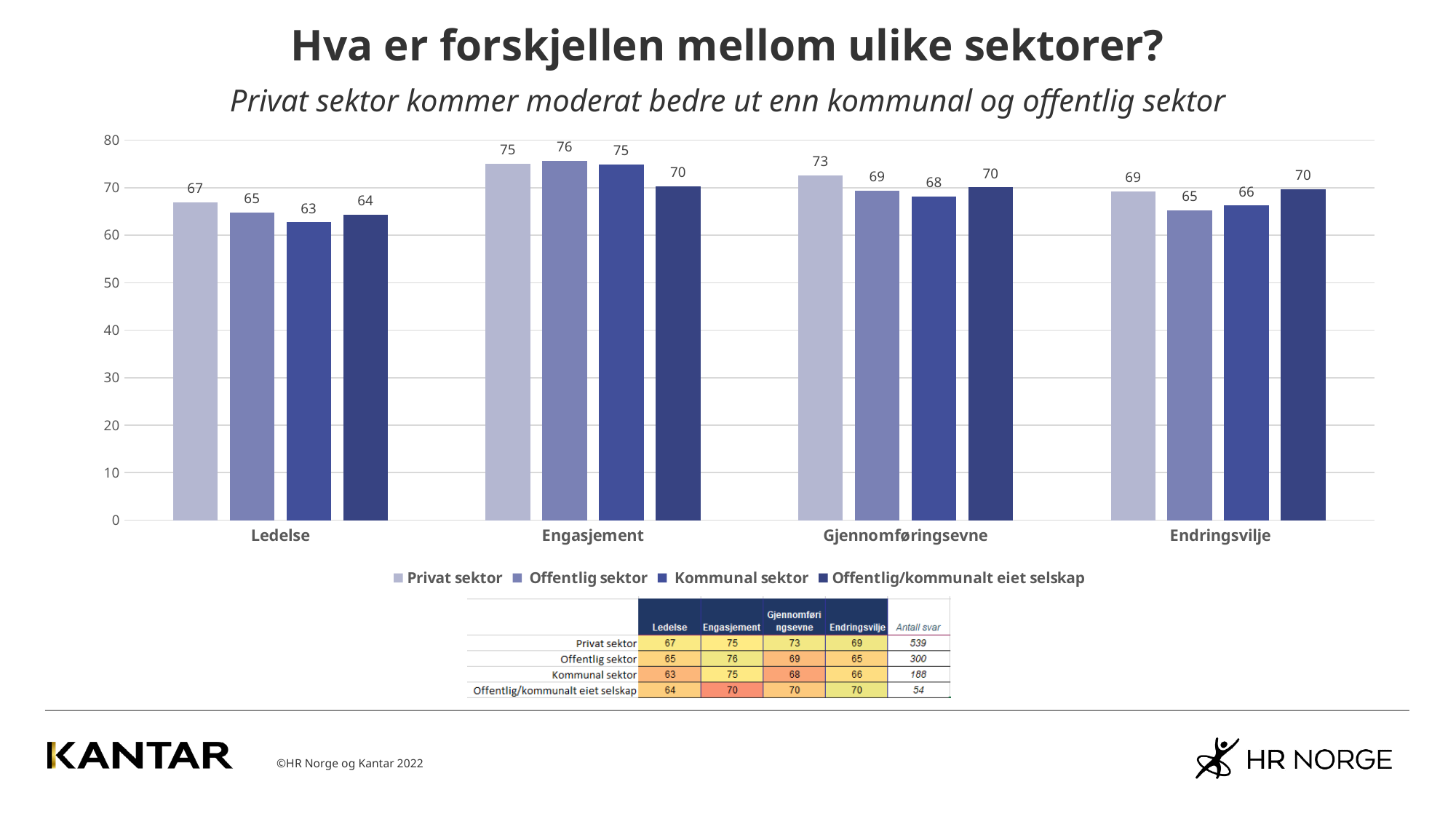
What is the value for Kommunal sektor in the Gjennomføringsevne category? 68 How many series does the legend list? 4 What is the difference between Privat sektor and Kommunal sektor in the Ledelse category? 4 Which sector has the lowest value in the Ledelse category? Kommunal sektor What is the title of the slide? Hva er forskjellen mellom ulike sektorer? How many categories are shown on the x axis of the chart? 4 What kind of chart is shown on the slide? Bar chart What is the value for Privat sektor in the Ledelse category? 67 Which is larger in the Endringsvilje category: Privat sektor or Offentlig sektor? Privat sektor What is the value for Offentlig/kommunalt eiet selskap in the Endringsvilje category? 70 Which sector has the highest value in the Gjennomføringsevne category? Privat sektor What is the value for Offentlig sektor in the Engasjement category? 76